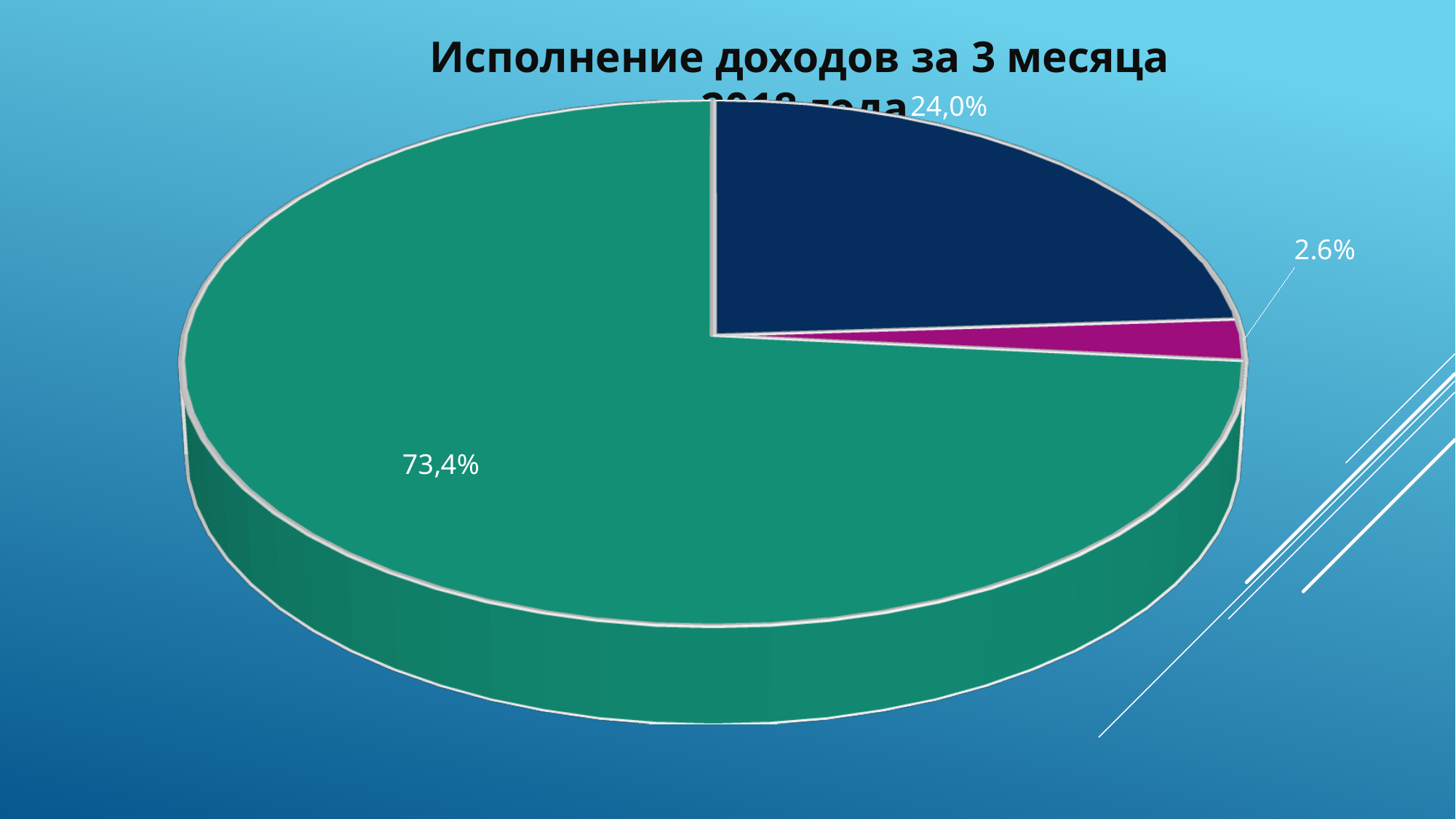
Which is larger, the green slice or the dark blue slice? the green slice Which slice of the pie chart is the largest? the green slice (73,4%) What colour is the largest slice of the pie chart? green What share of the pie does the green slice represent? 73,4% What percentage is shown for the magenta slice of the pie chart? 2.6% What percentage is shown for the green slice of the pie chart? 73,4% What is the difference in percentage points between the dark blue slice (24,0%) and the magenta slice (2.6%)? 21,4% What is the difference in percentage points between the green slice (73,4%) and the dark blue slice (24,0%)? 49,4% How many slices does the pie chart have? 3 Which slice of the pie chart is the smallest? the magenta slice (2.6%) What kind of chart is shown on the slide? pie chart What percentage is shown for the dark blue slice of the pie chart? 24,0%